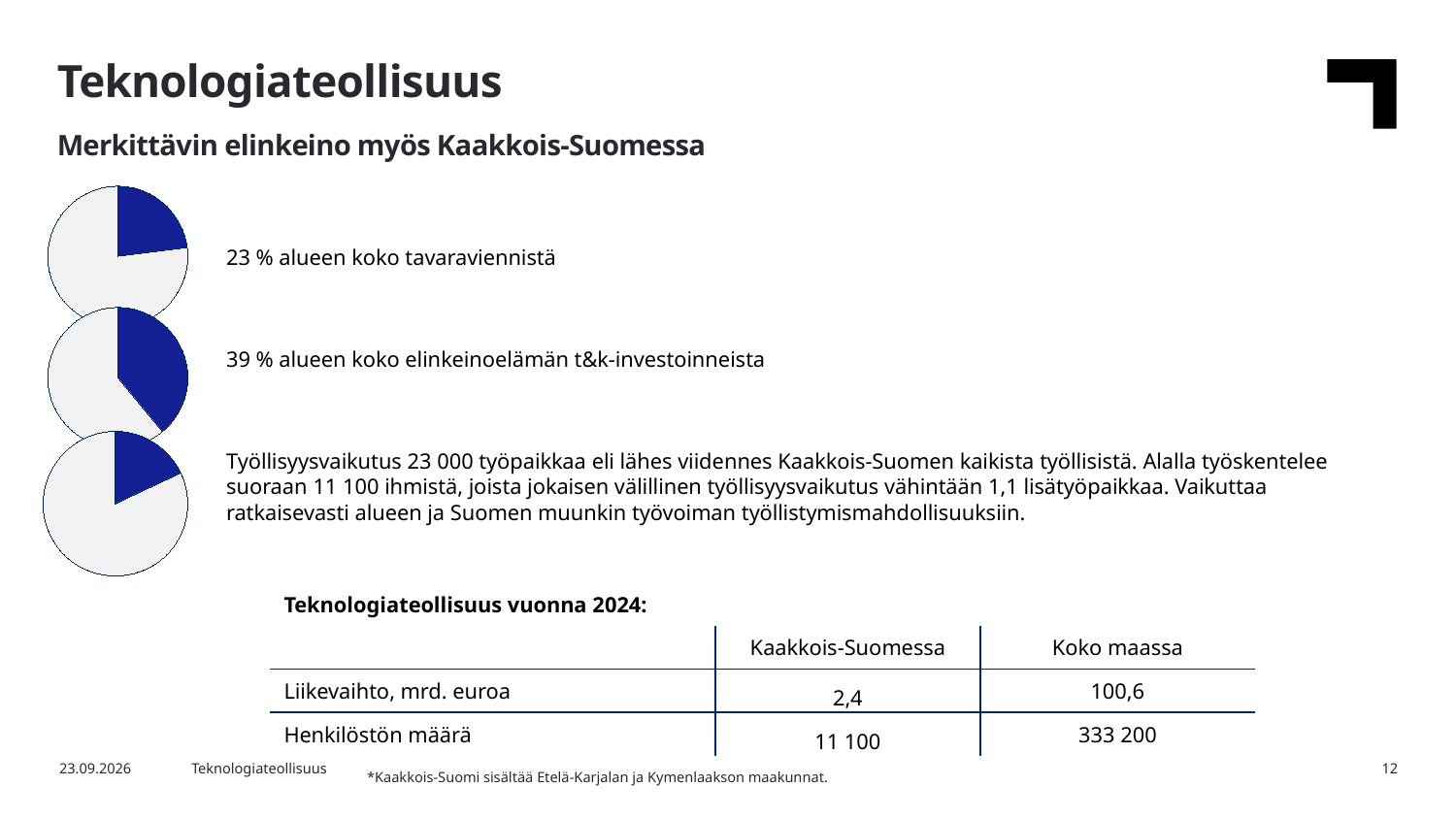
What kind of charts are the three charts on the left side of the slide? Pie charts How many pie charts are shown on the slide? 3 What does the top pie chart illustrate, according to the text next to it? 23 % alueen koko tavaraviennistä In the middle pie chart, what share does the blue slice represent (share of the region's business R&D investments)? 39 % In the top pie chart, what share does the blue slice represent (share of the region's total goods exports)? 23 % Which pie chart has the larger blue slice, the top one (tavaravienti) or the middle one (t&k-investoinnit)? The middle one (t&k-investoinnit) Is the blue slice in the middle pie chart greater or less than 50 % of the pie? less Is the blue slice in the bottom pie chart greater or less than 50 % of the pie? less Of the three pie charts, which one has the largest highlighted slice? The middle one (39 % of t&k-investoinnit) What colour is used for the highlighted slice in each of the pie charts? Blue What is the difference in percentage points between the blue slice of the middle pie chart (39 %) and the blue slice of the top pie chart (23 %)? 16 percentage points Is the blue slice in the middle pie chart greater or less than 25 % of the pie? greater